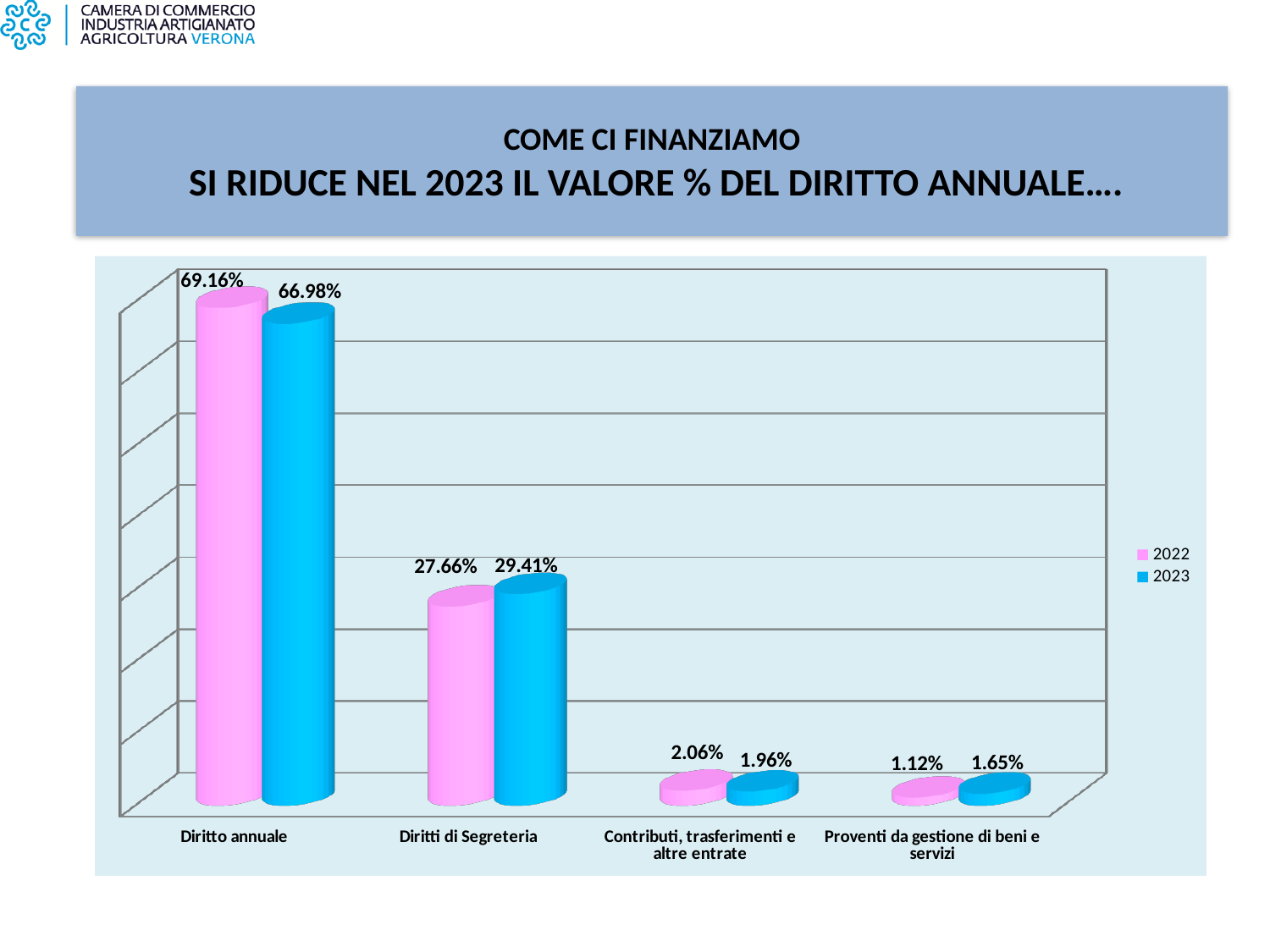
How many series does the legend list? 2 Which category has the lowest value in 2022? Proventi da gestione di beni e servizi What is the value for Proventi da gestione di beni e servizi in 2022? 1.12% Which category has the highest value in 2023? Diritto annuale What is the value for Diritti di Segreteria in 2023? 29.41% Which is larger for Contributi, trasferimenti e altre entrate: the 2022 value or the 2023 value? 2022 How many categories are shown on the x axis? 4 What is the difference between the 2023 and 2022 values for Diritti di Segreteria? 1.75% What is the value for Diritto annuale in 2023? 66.98% By how many percentage points did the value for Diritto annuale fall from 2022 to 2023? 2.18 What is the value for Diritto annuale in 2022? 69.16% What kind of chart is shown on the slide? Bar chart